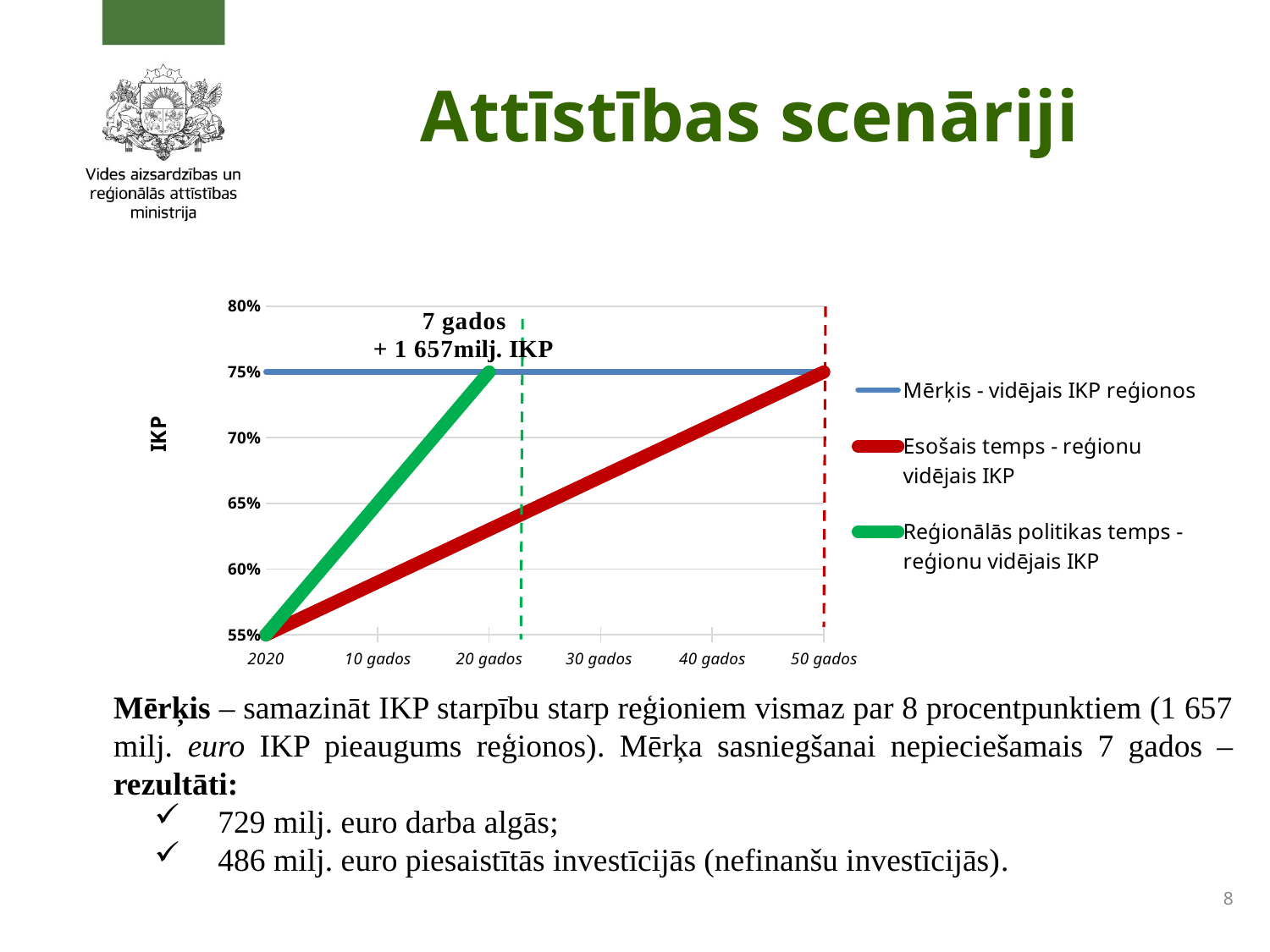
What IKP value does the 'Mērķis - vidējais IKP reģionos' line sit at? 75% Does the 'Esošais temps - reģionu vidējais IKP' line rise or fall from 2020 to '50 gados'? rise What kind of chart is shown on the slide? line chart Is the value for 'Reģionālās politikas temps - reģionu vidējais IKP' at '10 gados' greater or less than 60%? greater Is the value for 'Esošais temps - reģionu vidējais IKP' at '30 gados' greater or less than 60%? greater What value does 'Esošais temps - reģionu vidējais IKP' reach at '50 gados'? 75% What is the label of the y axis? IKP At '10 gados', which is higher: 'Esošais temps - reģionu vidējais IKP' or 'Reģionālās politikas temps - reģionu vidējais IKP'? Reģionālās politikas temps - reģionu vidējais IKP How many labels are shown on the x axis? 6 How many series does the legend list? 3 Is the value for 'Esošais temps - reģionu vidējais IKP' at '20 gados' greater or less than 70%? less What is the value of 'Esošais temps - reģionu vidējais IKP' in 2020? 55%